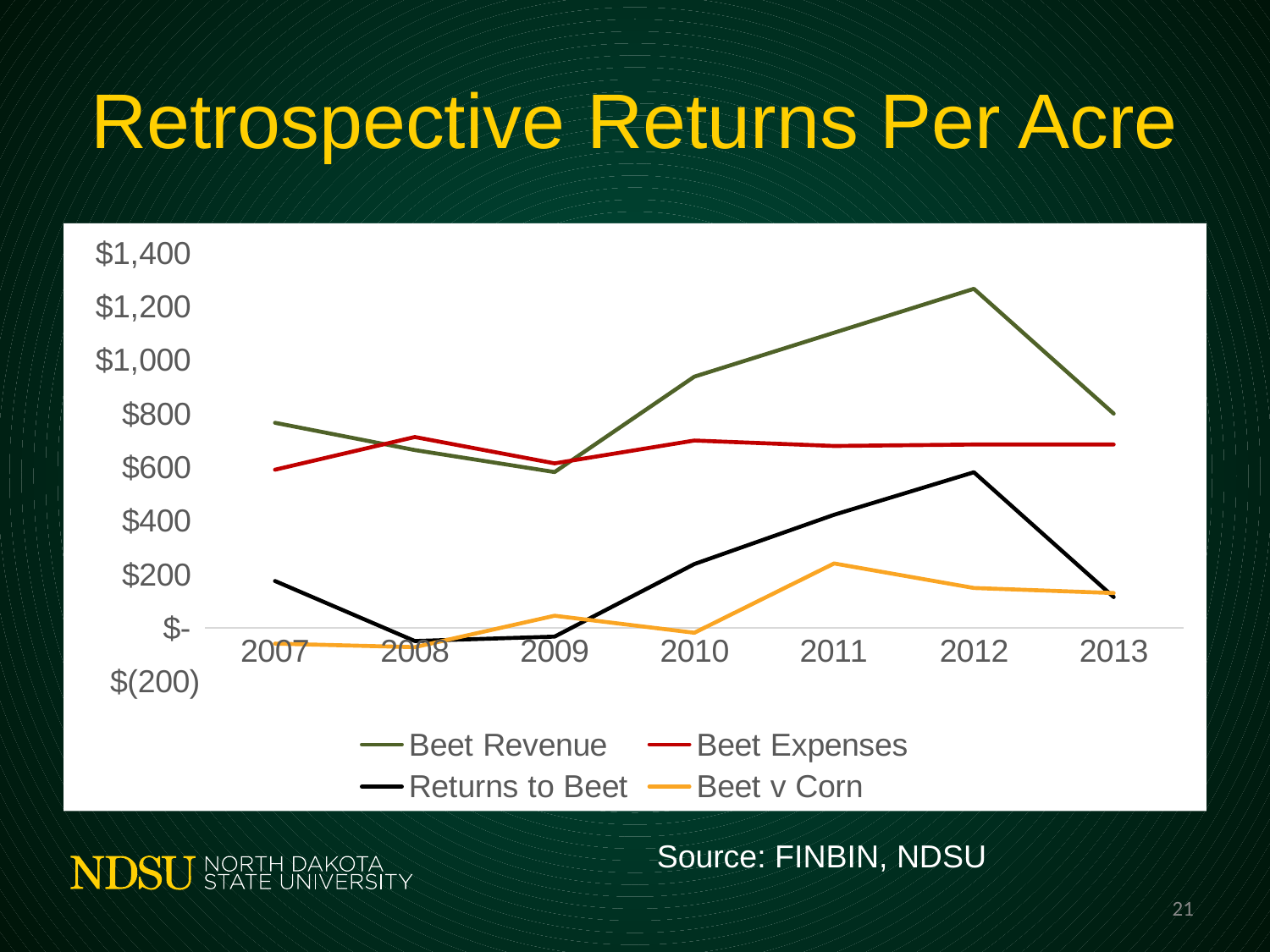
Does Beet Revenue rise or fall from 2009 to 2012? Rise Is the value for Beet Revenue in 2012 greater or less than $1,200? greater Is the value for Beet Expenses in 2007 greater or less than $800? less In which year is Beet Revenue highest? 2012 How many series does the legend list? 4 In which year is Beet v Corn highest? 2011 In which year is Beet Revenue lowest? 2009 In 2007, which is larger: Beet Revenue or Beet Expenses? Beet Revenue How many years are plotted along the x axis? 7 What kind of chart is shown on the slide? Line chart In which year is Returns to Beet highest? 2012 Is the value for Returns to Beet in 2010 greater or less than $400? less